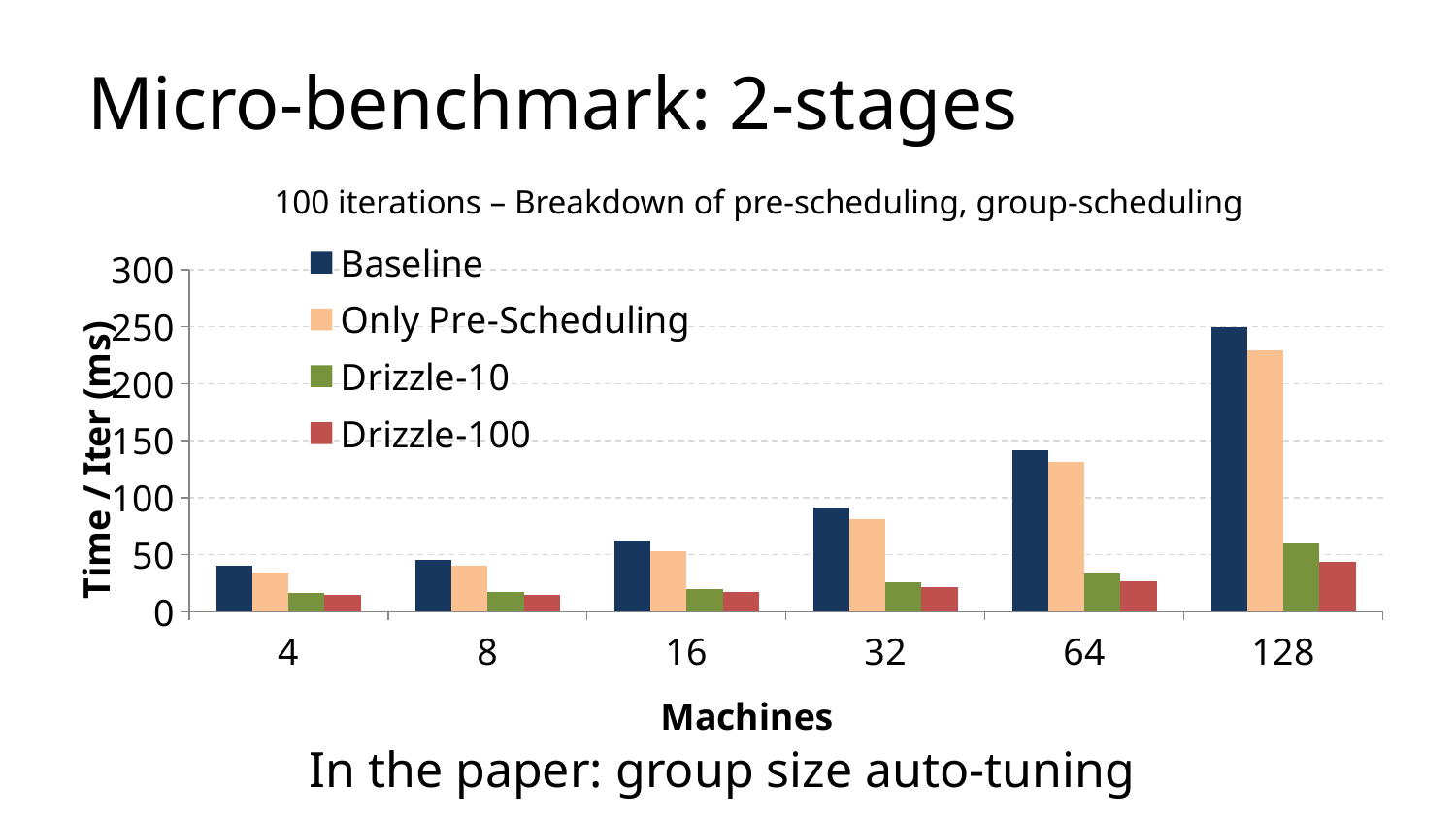
Is the Baseline value at 64 machines greater or less than 100? greater For which number of machines is the Baseline time per iteration highest? 128 At 128 machines, which is larger: Baseline or Only Pre-Scheduling? Baseline At 64 machines, which is larger: Drizzle-10 or Drizzle-100? Drizzle-10 How many series does the legend list? 4 How does the Baseline time per iteration change as the number of machines increases from 4 to 128? It rises What kind of chart is shown on the slide? bar chart Is the Only Pre-Scheduling value at 128 machines greater or less than 200? greater How many machine counts are shown along the x axis? 6 For which number of machines is the Baseline time per iteration lowest? 4 Is the Drizzle-100 value at 128 machines greater or less than 50? less What is the label of the y axis? Time / Iter (ms)